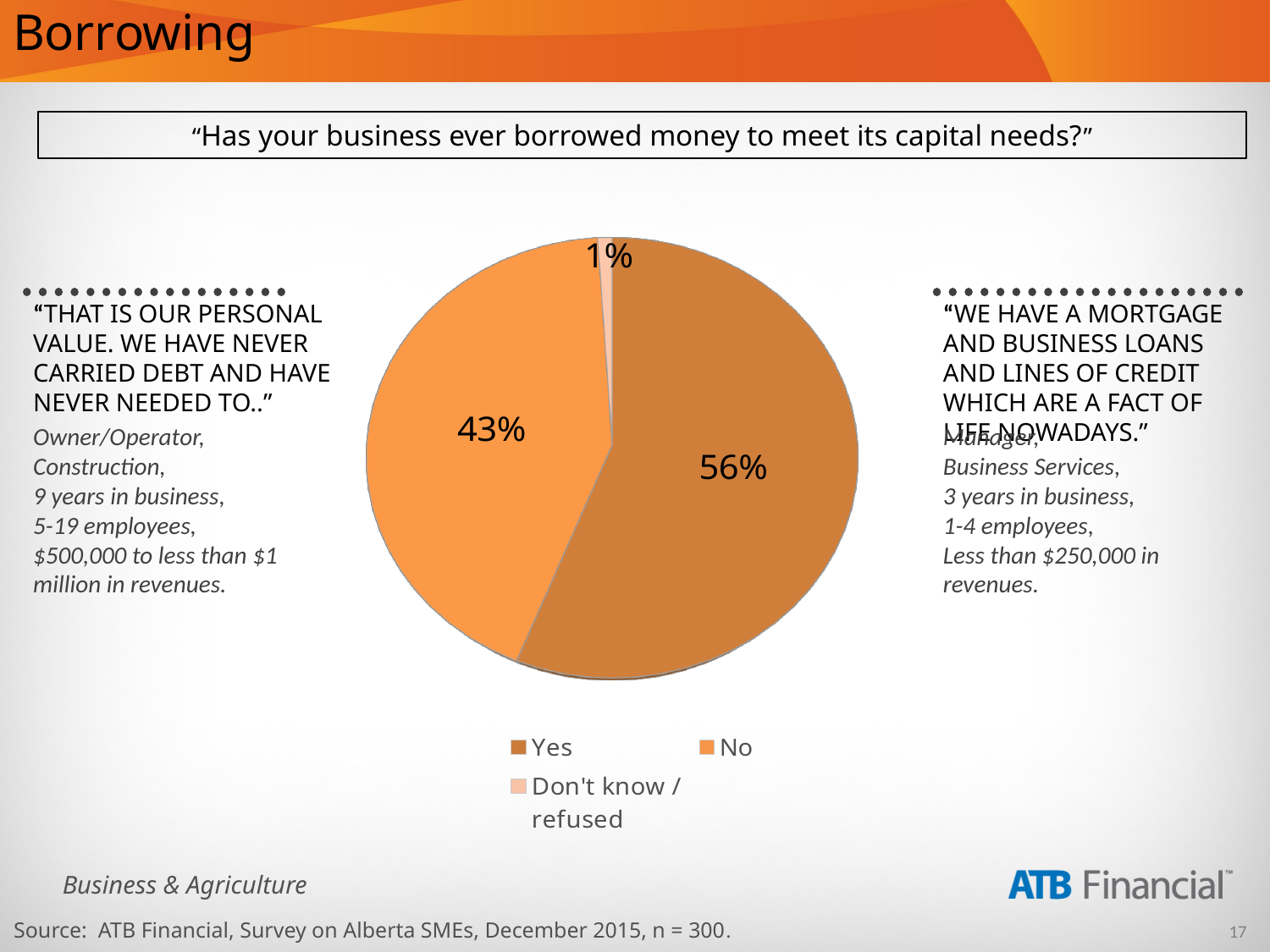
What percentage of respondents answered No? 43% Which is larger, the share for Yes or the share for No? Yes What kind of chart is shown on the slide? pie chart Which response has the smallest share of the pie? Don't know / refused How many entries does the legend list? 3 What percentage of respondents answered Don't know / refused? 1% Which response has the largest share of the pie? Yes Is the share for No greater or less than 50%? less What survey question does the pie chart answer? Has your business ever borrowed money to meet its capital needs? How many slices does the pie chart have? 3 What percentage of respondents answered Yes? 56% What is the difference in percentage points between the Yes and No shares? 13